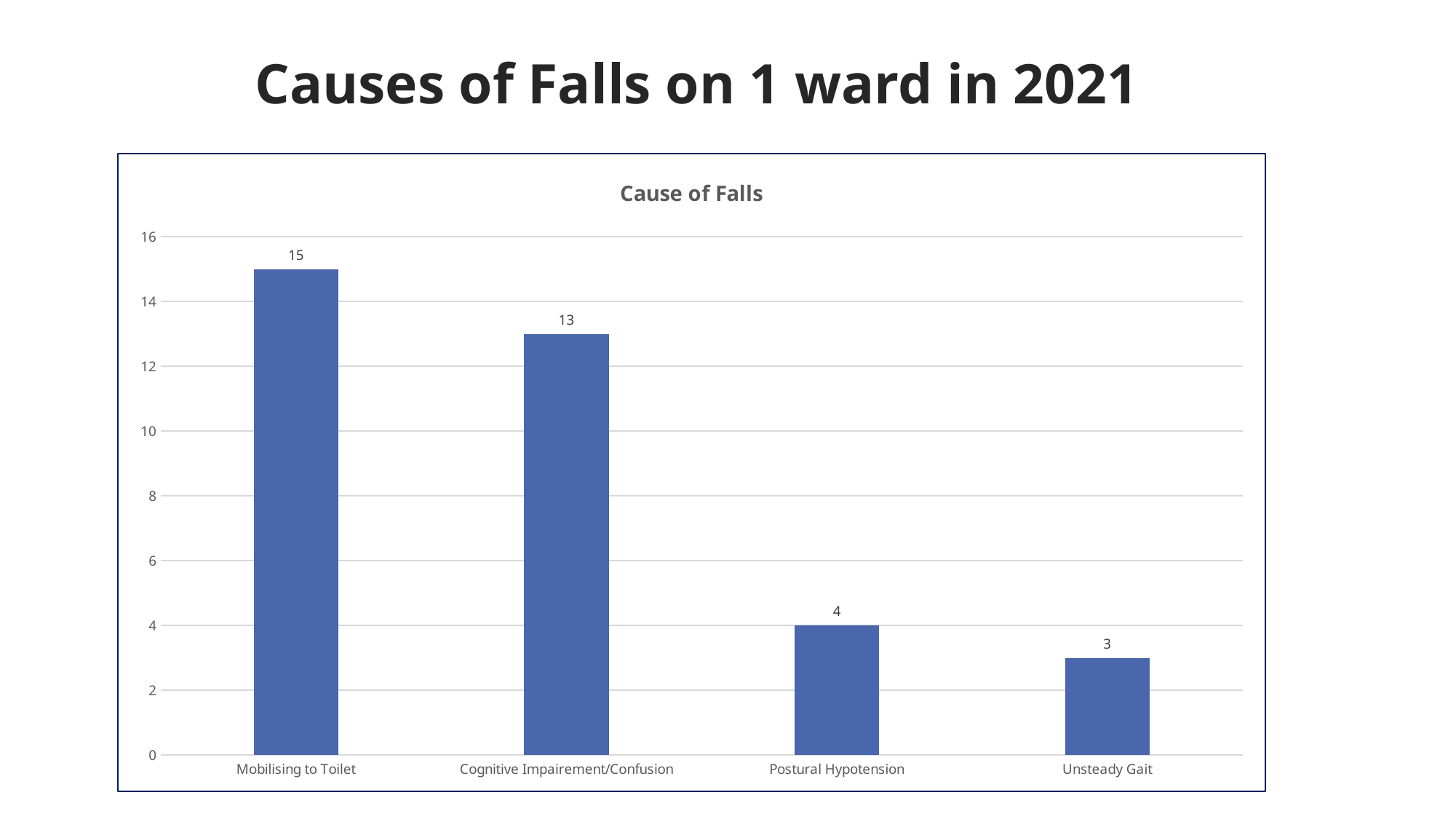
What is the difference between the values for Cognitive Impairement/Confusion and Postural Hypotension? 9 What is the value for Cognitive Impairement/Confusion? 13 What is the title shown inside the chart area? Cause of Falls Which is larger, the value for Postural Hypotension or the value for Unsteady Gait? Postural Hypotension Which cause of falls has the highest value? Mobilising to Toilet What kind of chart is shown on the slide? Bar chart What is the value for Unsteady Gait? 3 How many categories are shown on the chart? 4 What is the value for Postural Hypotension? 4 What is the difference between the values for Mobilising to Toilet and Cognitive Impairement/Confusion? 2 What is the value for Mobilising to Toilet? 15 Which cause of falls has the lowest value? Unsteady Gait